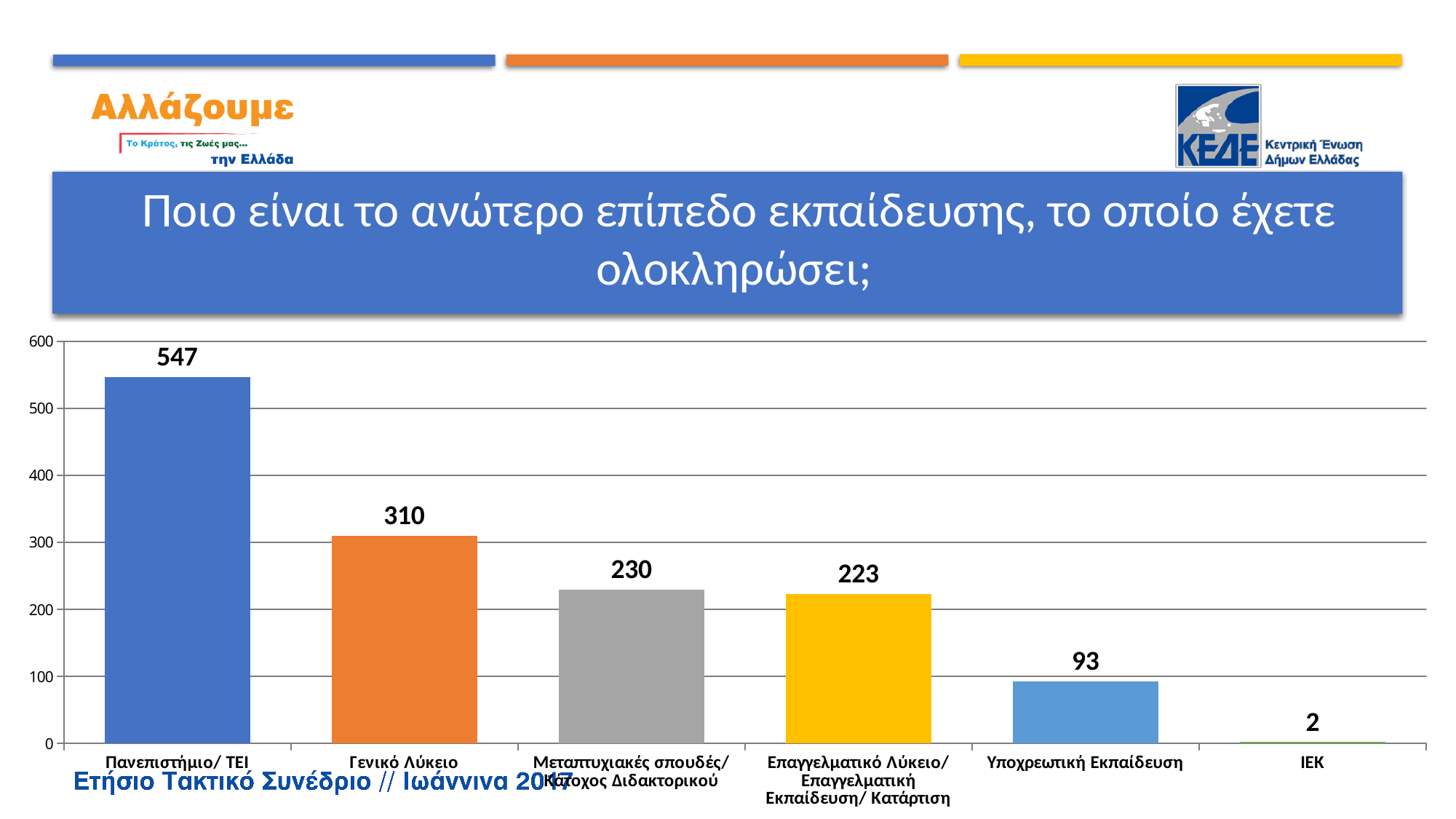
Which category has the highest value? Πανεπιστήμιο/ ΤΕΙ What kind of chart is shown on the slide? bar chart What is the difference between the values for Μεταπτυχιακές σπουδές/ Κάτοχος Διδακτορικού and Επαγγελματικό Λύκειο/ Επαγγελματική Εκπαίδευση/ Κατάρτιση? 7 What is the value for Υποχρεωτική Εκπαίδευση? 93 How many categories are shown in the chart? 6 What is the value for ΙΕΚ? 2 Which category has the lowest value? ΙΕΚ What is the value for Γενικό Λύκειο? 310 What is the value for Πανεπιστήμιο/ ΤΕΙ? 547 Which is larger, the value for Γενικό Λύκειο or the value for Υποχρεωτική Εκπαίδευση? Γενικό Λύκειο What is the difference between the values for Πανεπιστήμιο/ ΤΕΙ and Γενικό Λύκειο? 237 Is the value for Γενικό Λύκειο greater or less than 300? greater